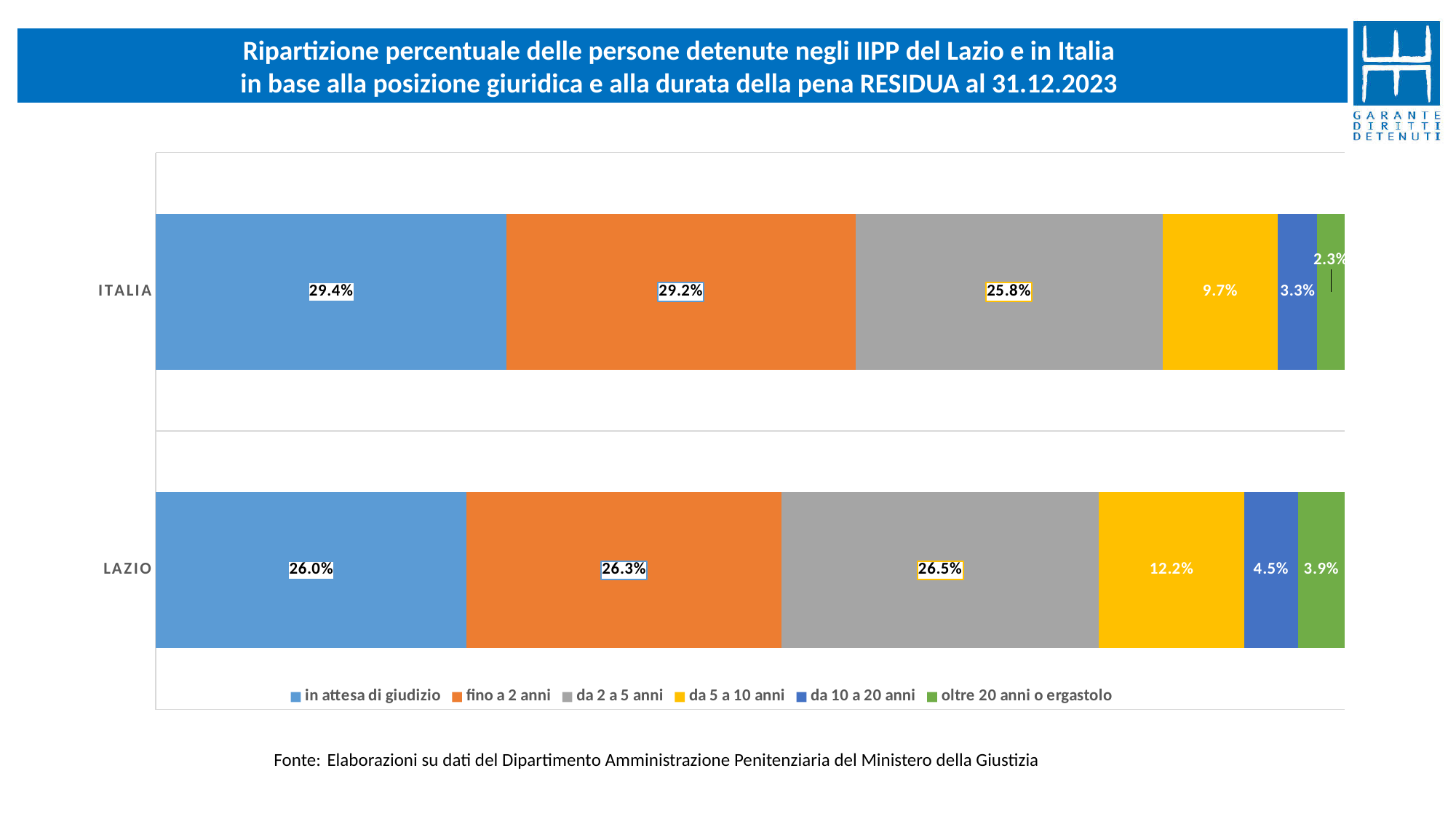
What is the value for 'da 10 a 20 anni' in the LAZIO bar? 4.5% What is the difference between the 'da 5 a 10 anni' values for LAZIO and ITALIA? 2.5% What is the value for 'oltre 20 anni o ergastolo' in the ITALIA bar? 2.3% What percentage of detainees in LAZIO have a residual sentence 'da 5 a 10 anni'? 12.2% What kind of chart is shown on the slide? Stacked bar chart Which series has the smallest share in the ITALIA bar? oltre 20 anni o ergastolo How many categories (bars) are shown on the y axis? 2 What colour represents 'da 2 a 5 anni' in the chart? Grey Which series has the largest share in the LAZIO bar? da 2 a 5 anni Which is larger: 'in attesa di giudizio' for ITALIA or for LAZIO? ITALIA How many series does the legend list? 6 What percentage of detainees in ITALIA are 'in attesa di giudizio'? 29.4%